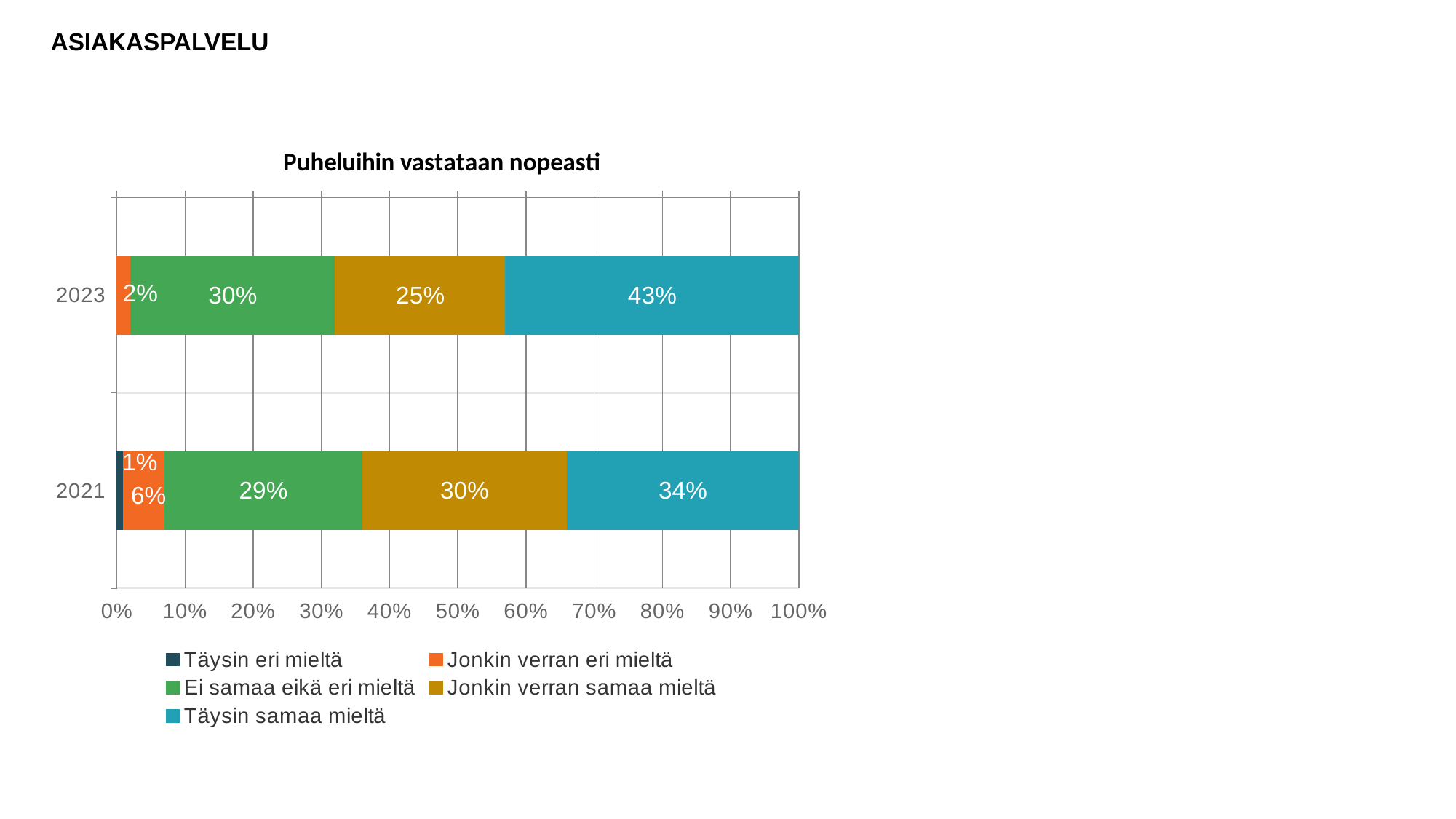
What is the value for 'Täysin samaa mieltä' in 2023? 43% What is the title of the chart? Puheluihin vastataan nopeasti What type of chart is shown on the slide? Stacked bar chart How many series does the legend list? 5 What is the value for 'Täysin samaa mieltä' in 2021? 34% Which series has the highest value in 2023? Täysin samaa mieltä What is the value for 'Täysin eri mieltä' in 2021? 1% What is the difference between the 'Täysin samaa mieltä' values for 2023 and 2021? 9% How many categories (years) are shown on the vertical axis? 2 What is the value for 'Jonkin verran eri mieltä' in 2023? 2% Which year has the larger value for 'Jonkin verran samaa mieltä', 2023 or 2021? 2021 What is the value for 'Jonkin verran samaa mieltä' in 2021? 30%